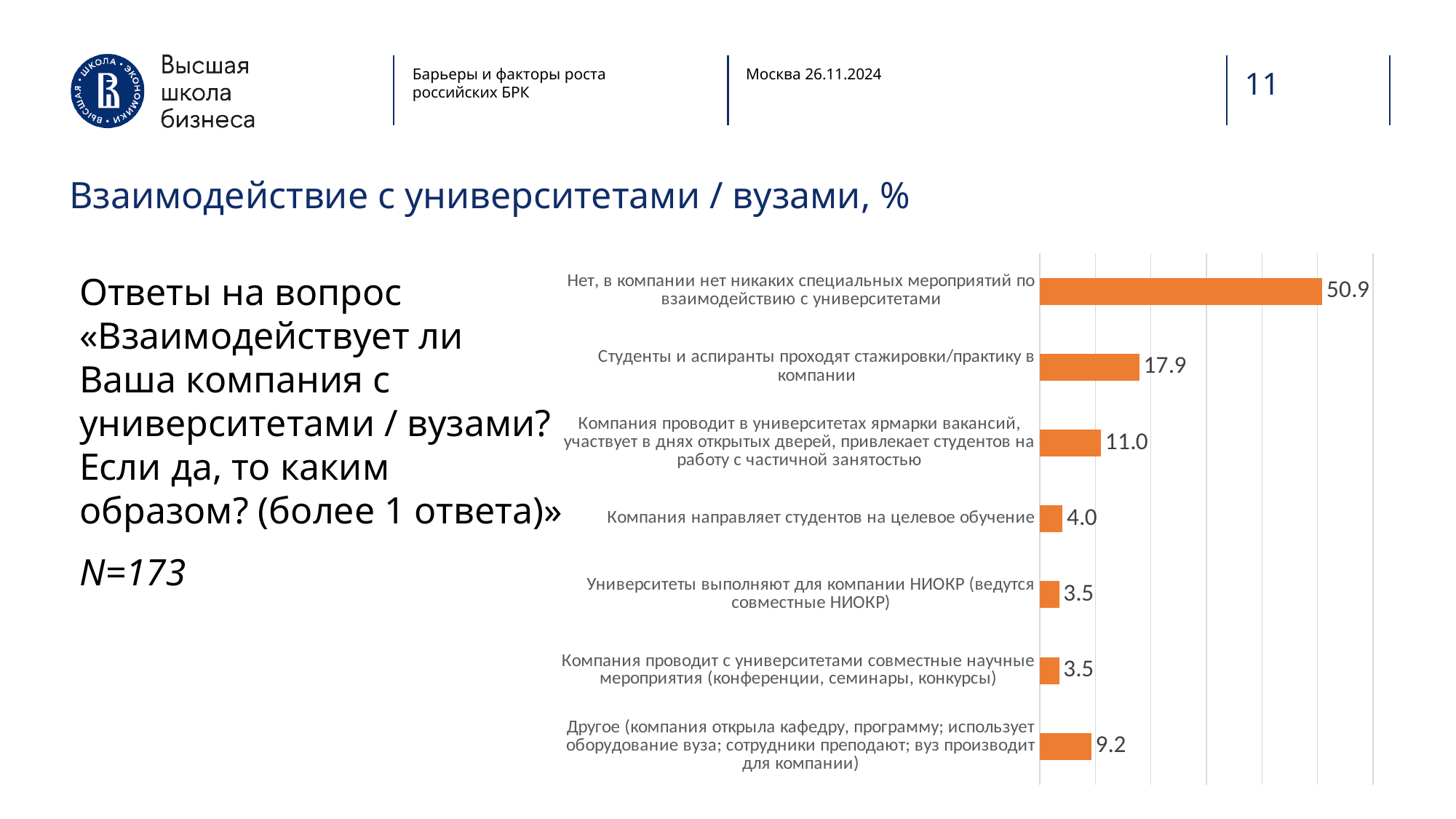
How many categories are shown in the chart? 7 What is the difference between the value for «Компания проводит в университетах ярмарки вакансий, участвует в днях открытых дверей, привлекает студентов на работу с частичной занятостью» and the value for «Другое»? 1.8 What value is shown for the category «Другое (компания открыла кафедру, программу; использует оборудование вуза; сотрудники преподают; вуз производит для компании)»? 9.2 Which category has the highest value in the chart? Нет, в компании нет никаких специальных мероприятий по взаимодействию с университетами What type of chart is shown on the slide? Bar chart Which is larger: the value for «Другое» or the value for «Компания направляет студентов на целевое обучение»? Другое What value is shown for «Компания направляет студентов на целевое обучение»? 4.0 What value is shown for «Университеты выполняют для компании НИОКР (ведутся совместные НИОКР)»? 3.5 What value is shown for the category «Нет, в компании нет никаких специальных мероприятий по взаимодействию с университетами»? 50.9 What is the sample size (N) stated on the slide for the survey question? N=173 What is the difference between the value for «Нет, в компании нет никаких специальных мероприятий по взаимодействию с университетами» and the value for «Студенты и аспиранты проходят стажировки/практику в компании»? 33.0 What value is shown for «Студенты и аспиранты проходят стажировки/практику в компании»? 17.9